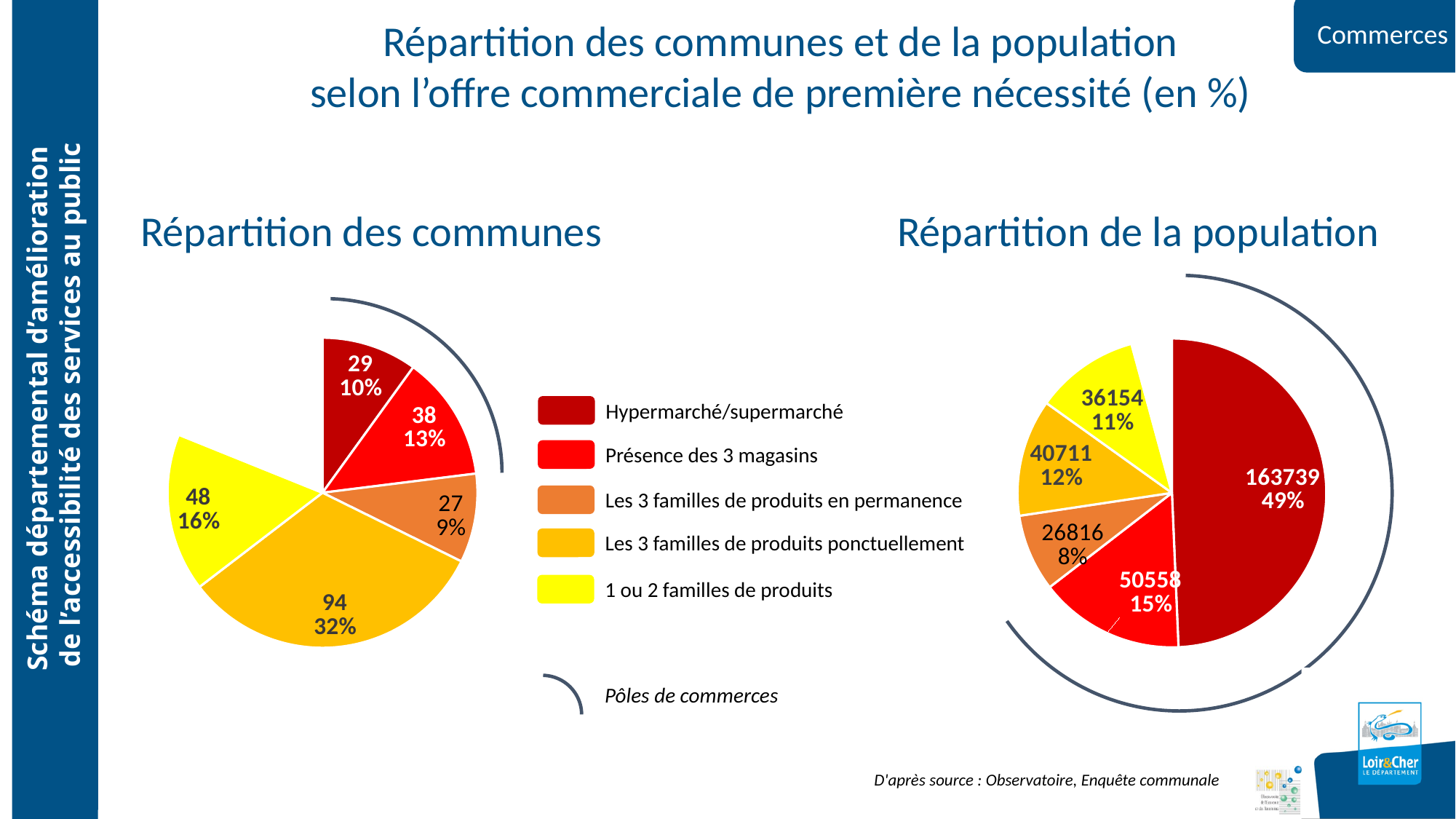
In the 'Répartition des communes' chart, how many communes are in the 'Les 3 familles de produits ponctuellement' category? 94 In the 'Répartition de la population' chart, which is larger: the value for 'Présence des 3 magasins' or for '1 ou 2 familles de produits'? Présence des 3 magasins How many categories does the legend list? 5 Which colour represents 'Présence des 3 magasins' in the legend? Red In the 'Répartition des communes' chart, what percentage is shown for 'Hypermarché/supermarché'? 10% In the 'Répartition des communes' chart, which category has the smallest slice? Les 3 familles de produits en permanence In the 'Répartition de la population' chart, what share of the pie does 'Les 3 familles de produits ponctuellement' represent? 12% In the 'Répartition de la population' chart, what percentage is shown for 'Les 3 familles de produits en permanence'? 8% What type of charts are shown on the slide? Pie charts In the 'Répartition de la population' chart, which category has the largest slice? Hypermarché/supermarché In the 'Répartition des communes' chart, what is the difference between the number of communes for 'Les 3 familles de produits ponctuellement' and '1 ou 2 familles de produits'? 46 In the 'Répartition de la population' chart, what is the population value for 'Hypermarché/supermarché'? 163739